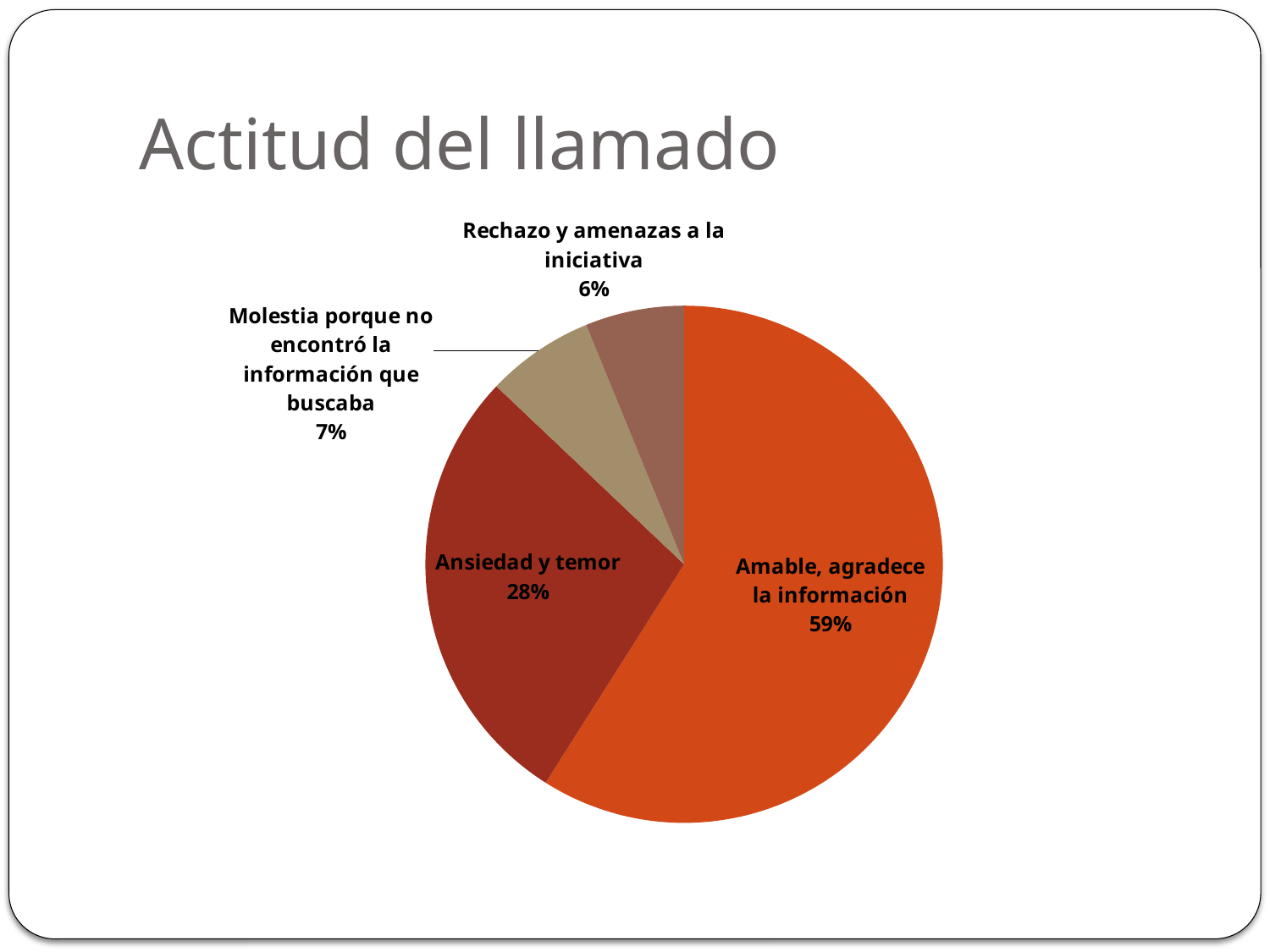
Which category has the smallest slice of the pie? Rechazo y amenazas a la iniciativa What share of the pie does "Amable, agradece la información" represent? 59% What share of the pie does "Rechazo y amenazas a la iniciativa" represent? 6% What is the combined share of "Molestia porque no encontró la información que buscaba" and "Rechazo y amenazas a la iniciativa"? 13% Which is larger, the slice for "Ansiedad y temor" or the slice for "Molestia porque no encontró la información que buscaba"? Ansiedad y temor Which category has the largest slice of the pie? Amable, agradece la información What share of the pie does "Ansiedad y temor" represent? 28% What is the title of the slide? Actitud del llamado What is the difference in percentage points between "Amable, agradece la información" and "Ansiedad y temor"? 31 What kind of chart is shown on the slide? pie chart How many categories are shown in the pie chart? 4